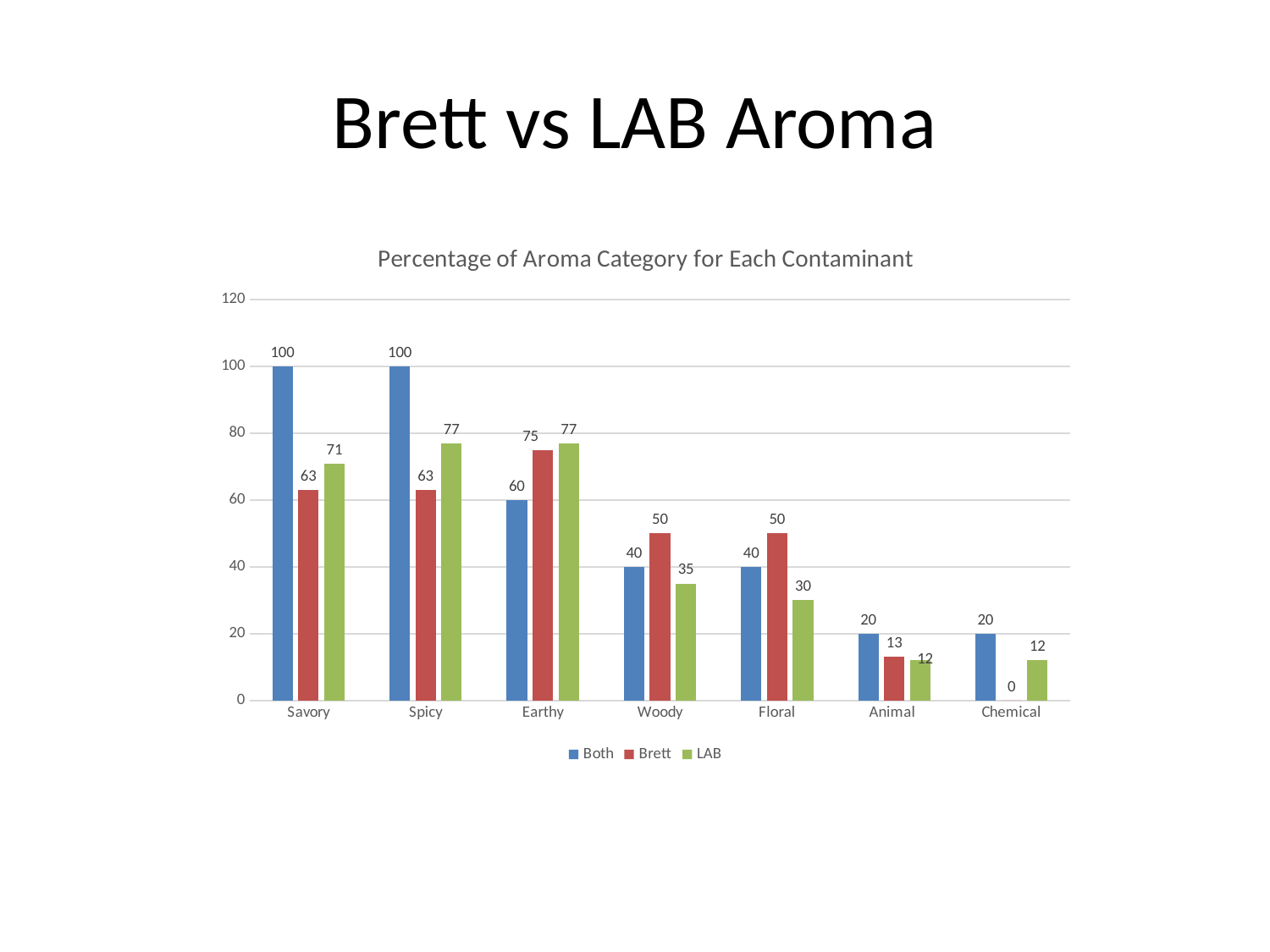
What is the value for Both in the Woody category? 40 How many series does the legend list? 3 Which is larger in the Floral category, the Brett value or the LAB value? Brett Which category has the lowest value for the LAB series? Animal and Chemical (both 12) What is the title of the chart? Percentage of Aroma Category for Each Contaminant What is the value for Brett in the Chemical category? 0 What is the difference between the Both and Brett values in the Savory category? 37 How many aroma categories are shown on the x axis? 7 What is the value for LAB in the Savory category? 71 What is the value for Brett in the Earthy category? 75 What kind of chart is shown on the slide? Bar chart Which category has the highest value for the Brett series? Earthy